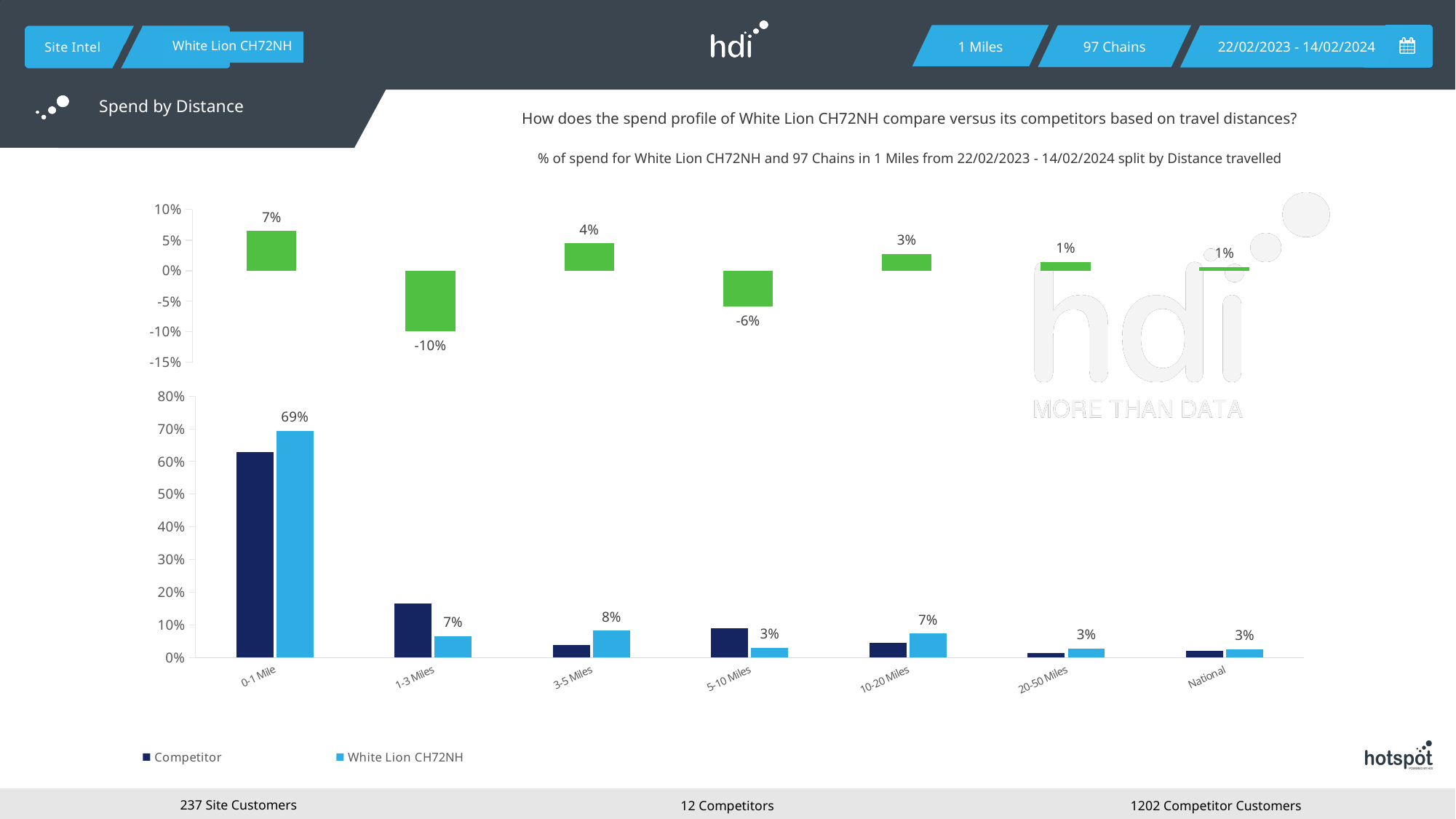
In the bottom chart, is the Competitor value at 0-1 Mile greater or less than 60%? greater How many distance bands are shown on the x axis of the bottom chart? 7 In the bottom chart, what is the value for White Lion CH72NH at 3-5 Miles? 8% In the top chart, which distance band has the highest value? 0-1 Mile In the top chart, what is the value shown for 5-10 Miles? -6% In the bottom chart, what is the value for White Lion CH72NH at 0-1 Mile? 69% In the bottom chart, which distance band has the highest White Lion CH72NH value? 0-1 Mile In the top chart, what is the value shown for 1-3 Miles? -10% In the bottom chart, at 1-3 Miles, which is larger: the Competitor bar or the White Lion CH72NH bar? Competitor In the top chart, which distance band has the lowest value? 1-3 Miles How many series does the legend of the bottom chart list? 2 In the bottom chart, what is the difference between the White Lion CH72NH values at 0-1 Mile and 1-3 Miles? 62%